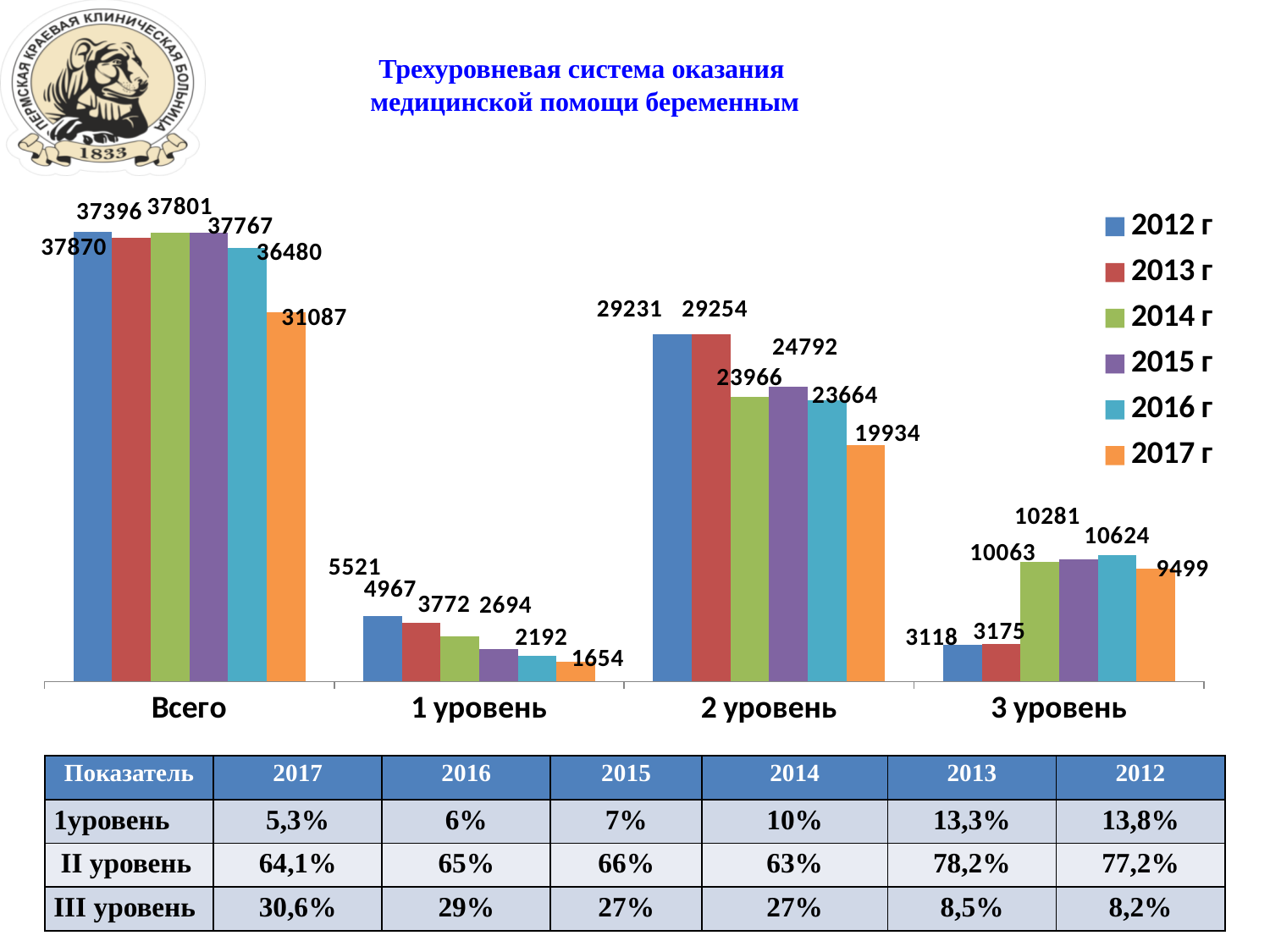
How many categories are shown on the x axis? 4 What is the value for 2017 г in the Всего category? 31087 Which is larger in the 2 уровень category: the value for 2014 г or 2015 г? 2015 г Which year has the lowest value in the 1 уровень category? 2017 г What kind of chart is shown on the slide? bar chart Which year has the highest value in the 3 уровень category? 2016 г How many series does the legend list? 6 What is the value for 2012 г in the 1 уровень category? 5521 Which colour represents 2017 г in the legend? orange What is the difference between the 2012 г and 2017 г values in the 2 уровень category? 9297 What is the value for 2014 г in the 3 уровень category? 10063 Do the values in the 1 уровень category rise or fall from 2012 г to 2017 г? fall